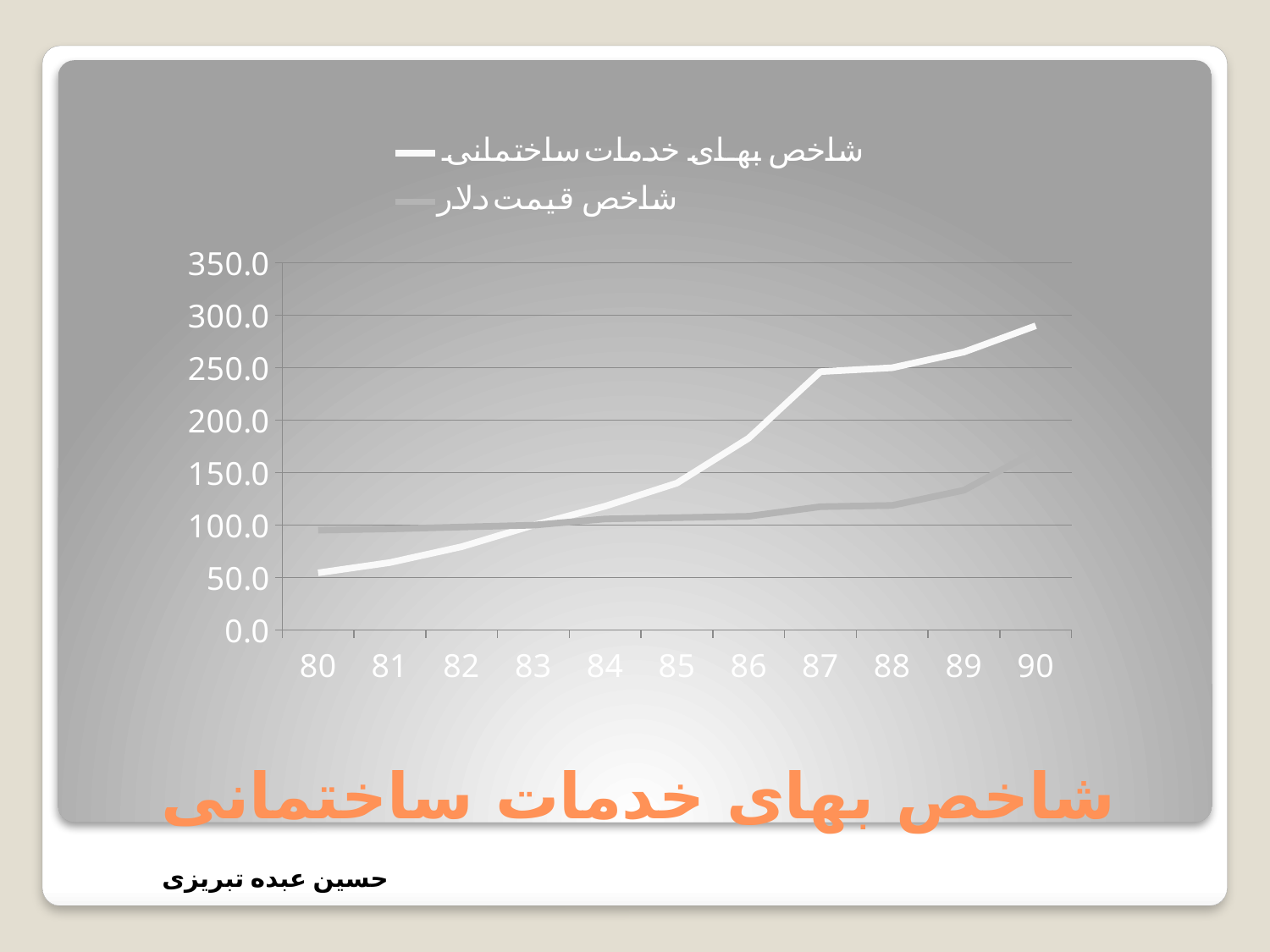
Is the value of the construction services price index (شاخص بهای خدمات ساختمانی) at 87 greater or less than 200.0? greater Is the value of the construction services price index (شاخص بهای خدمات ساختمانی) at 80 greater or less than 100.0? less What is the title shown below the chart? شاخص بهای خدمات ساختمانی At 90, which series has the higher value? شاخص بهای خدمات ساختمانی At 80, which series has the higher value? شاخص قیمت دلار In which year does the construction services price index (شاخص بهای خدمات ساختمانی) reach its highest value? 90 How many years are shown along the x axis? 11 Is the value of the construction services price index (شاخص بهای خدمات ساختمانی) at 90 greater or less than 250.0? greater How many series does the legend list? 2 What kind of chart is shown on the slide? line chart Does the construction services price index (شاخص بهای خدمات ساختمانی) rise or fall from 80 to 90? rise